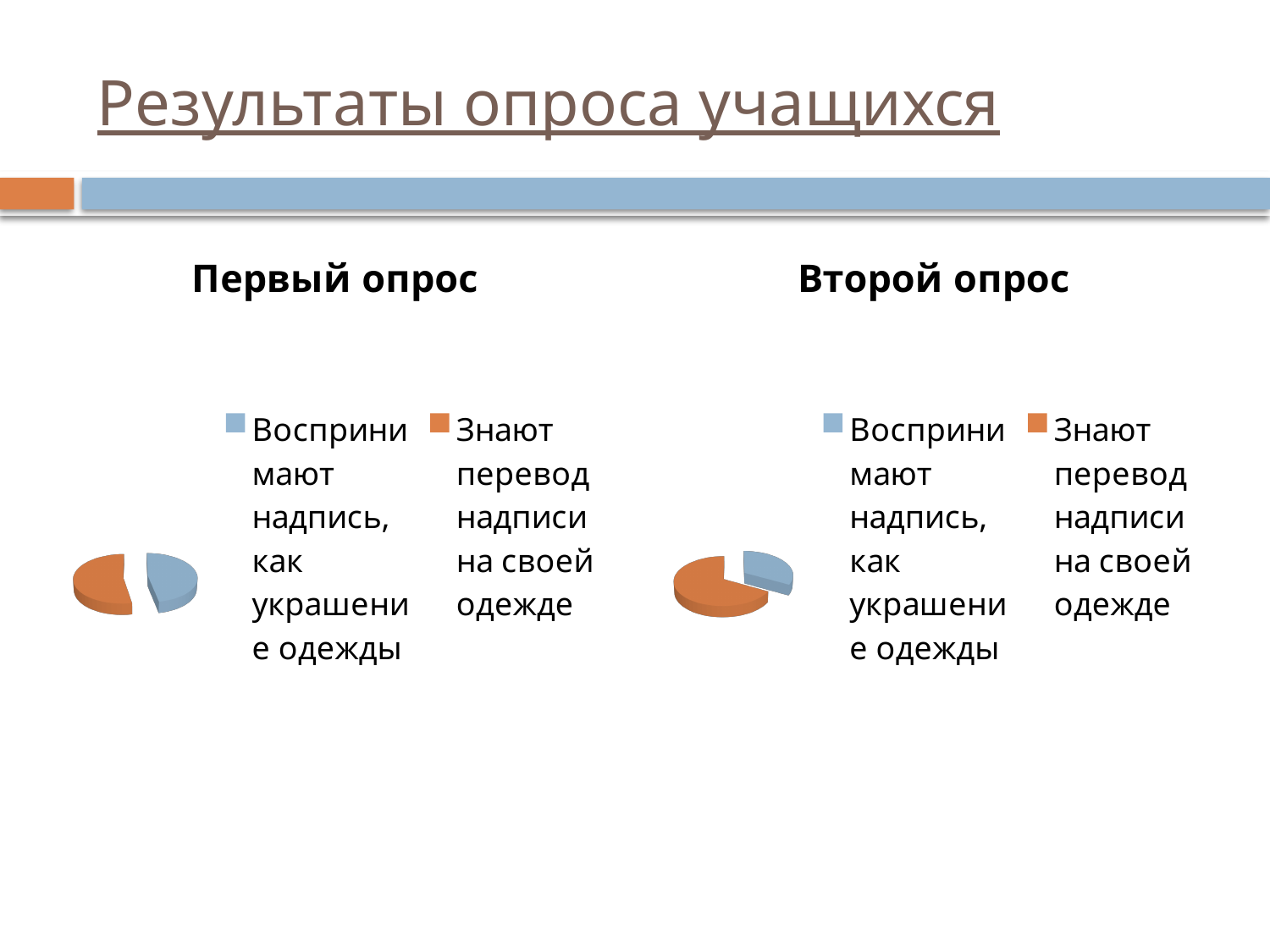
How many slices does the "Второй опрос" pie chart have? 2 How many entries does the legend of the "Второй опрос" chart list? 2 How many pie charts are shown on the slide? 2 In the "Второй опрос" chart, which category has the smallest slice? Воспринимают надпись, как украшение одежды In the "Второй опрос" chart, which category has the largest slice? Знают перевод надписи на своей одежде What kind of chart is used for "Первый опрос"? pie chart How many entries does the legend of the "Первый опрос" chart list? 2 How many slices does the "Первый опрос" pie chart have? 2 In the "Первый опрос" chart, what colour is the slice for "Знают перевод надписи на своей одежде"? orange In the "Второй опрос" chart, which slice is larger: "Воспринимают надпись, как украшение одежды" or "Знают перевод надписи на своей одежде"? Знают перевод надписи на своей одежде What kind of chart is used for "Второй опрос"? pie chart